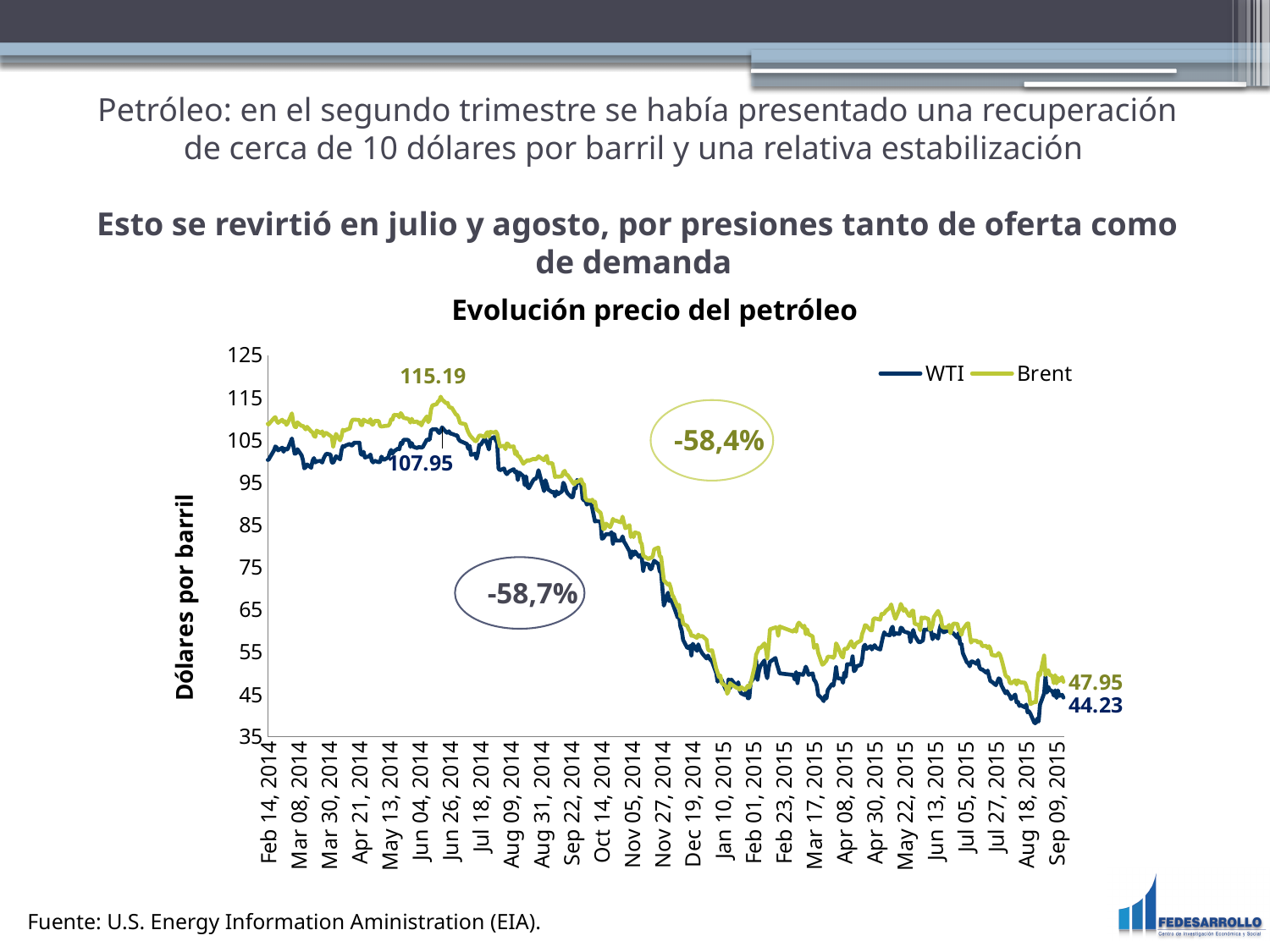
How many series does the legend list? 2 At the right end of the chart, which series has the higher labelled value, WTI or Brent? Brent What is the peak value labelled on the WTI series in the chart? 107.95 What is the last value labelled for Brent at the right end of the chart? 47.95 What is the last value labelled for WTI at the right end of the chart? 44.23 What is the difference between the labelled Brent peak (115.19) and the labelled WTI peak (107.95)? 7.24 What is the difference between the final labelled Brent value (47.95) and the final labelled WTI value (44.23)? 3.72 Is the WTI value around Jan 10, 2015 greater or less than 55? less Overall, do the oil prices rise or fall from Feb 2014 to Sep 2015 along the x axis? Fall What kind of chart is shown on the slide? Line chart What is the peak value labelled on the Brent series in the chart? 115.19 What is the label on the vertical axis of the chart? Dólares por barril